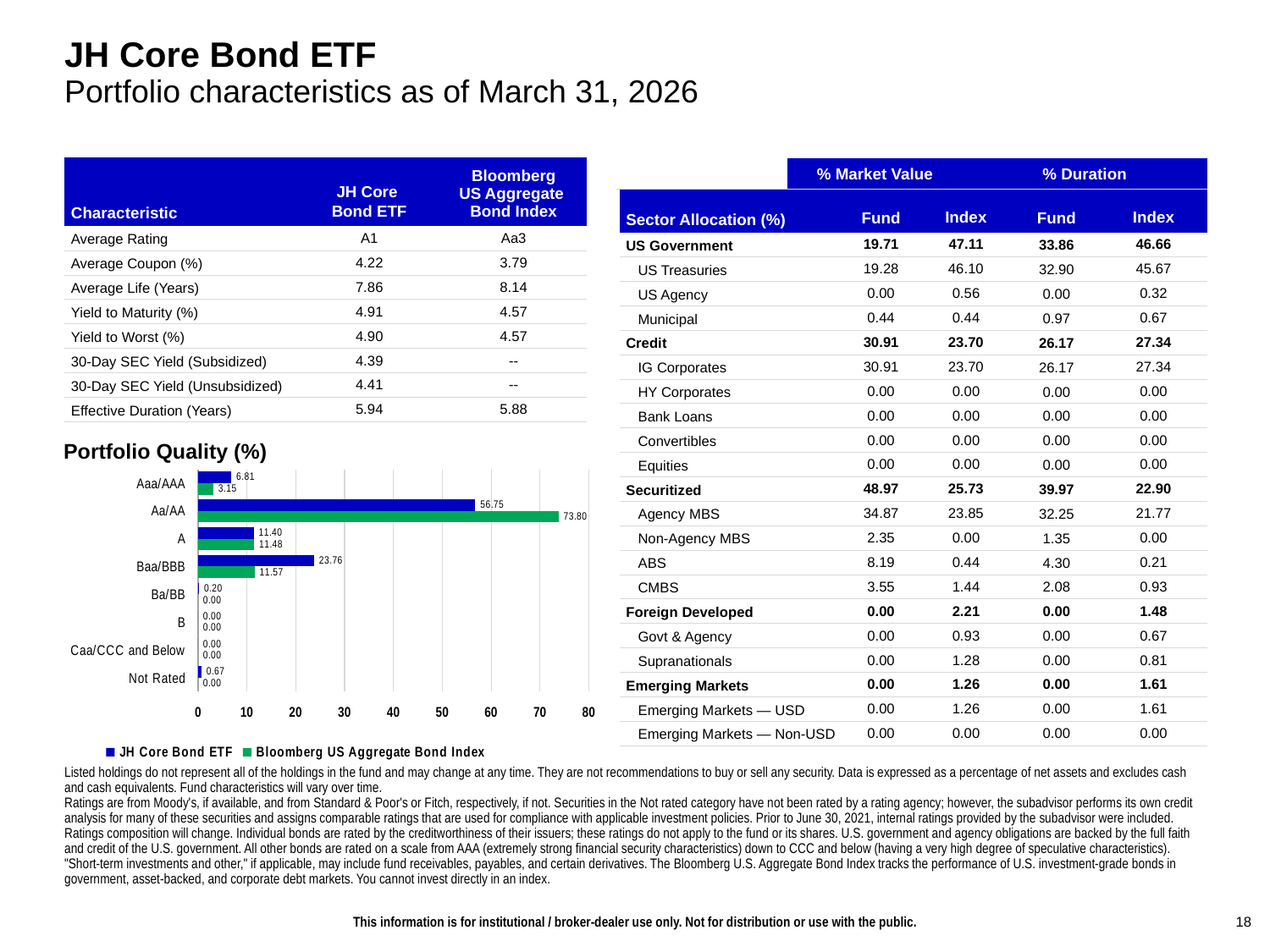
What type of chart is the Portfolio Quality (%) chart? Bar chart In the Portfolio Quality (%) chart, what is the value for the Bloomberg US Aggregate Bond Index in the Aa/AA category? 73.80 How many rating categories are shown in the Portfolio Quality (%) chart? 8 In the Portfolio Quality (%) chart, what is the JH Core Bond ETF value for Baa/BBB? 23.76 In the Portfolio Quality (%) chart, which rating category has the highest value for JH Core Bond ETF? Aa/AA In the Portfolio Quality (%) chart, is the JH Core Bond ETF value for Aa/AA greater or less than 50? greater In the Portfolio Quality (%) chart, what is the value for JH Core Bond ETF in the Aa/AA category? 56.75 In the Portfolio Quality (%) chart, which is larger for Aaa/AAA: the JH Core Bond ETF value or the Bloomberg US Aggregate Bond Index value? JH Core Bond ETF In the Portfolio Quality (%) chart, what is the difference between the Bloomberg US Aggregate Bond Index and JH Core Bond ETF values for Aa/AA? 17.05 How many series does the legend of the Portfolio Quality (%) chart list? 2 In the Portfolio Quality (%) chart, what is the Bloomberg US Aggregate Bond Index value for Aaa/AAA? 3.15 In the Portfolio Quality (%) chart, what is the difference between the JH Core Bond ETF and Bloomberg US Aggregate Bond Index values for Baa/BBB? 12.19